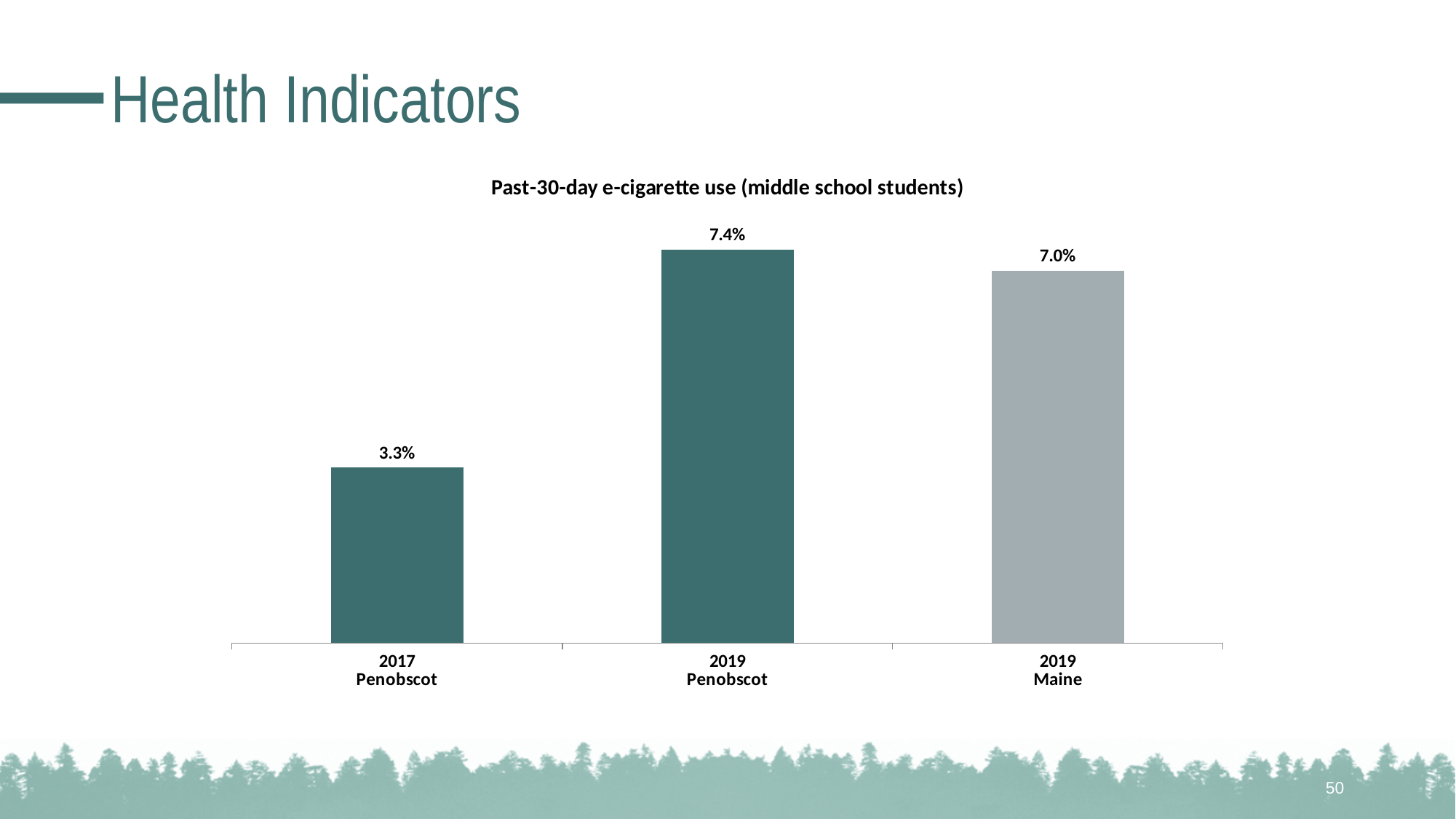
How many bars are shown in the chart? 3 Did the Penobscot value rise or fall from 2017 to 2019? Rise What is the value for 2019 Maine? 7.0% What is the value for 2017 Penobscot? 3.3% What is the title of the chart? Past-30-day e-cigarette use (middle school students) What is the difference between the 2019 Penobscot and 2017 Penobscot values? 4.1% What is the value for 2019 Penobscot? 7.4% Which is larger, the value for 2019 Penobscot or 2019 Maine? 2019 Penobscot What kind of chart is shown on the slide? Bar chart What is the difference between the 2019 Penobscot and 2019 Maine values? 0.4% Which category has the lowest value? 2017 Penobscot Which category has the highest value? 2019 Penobscot